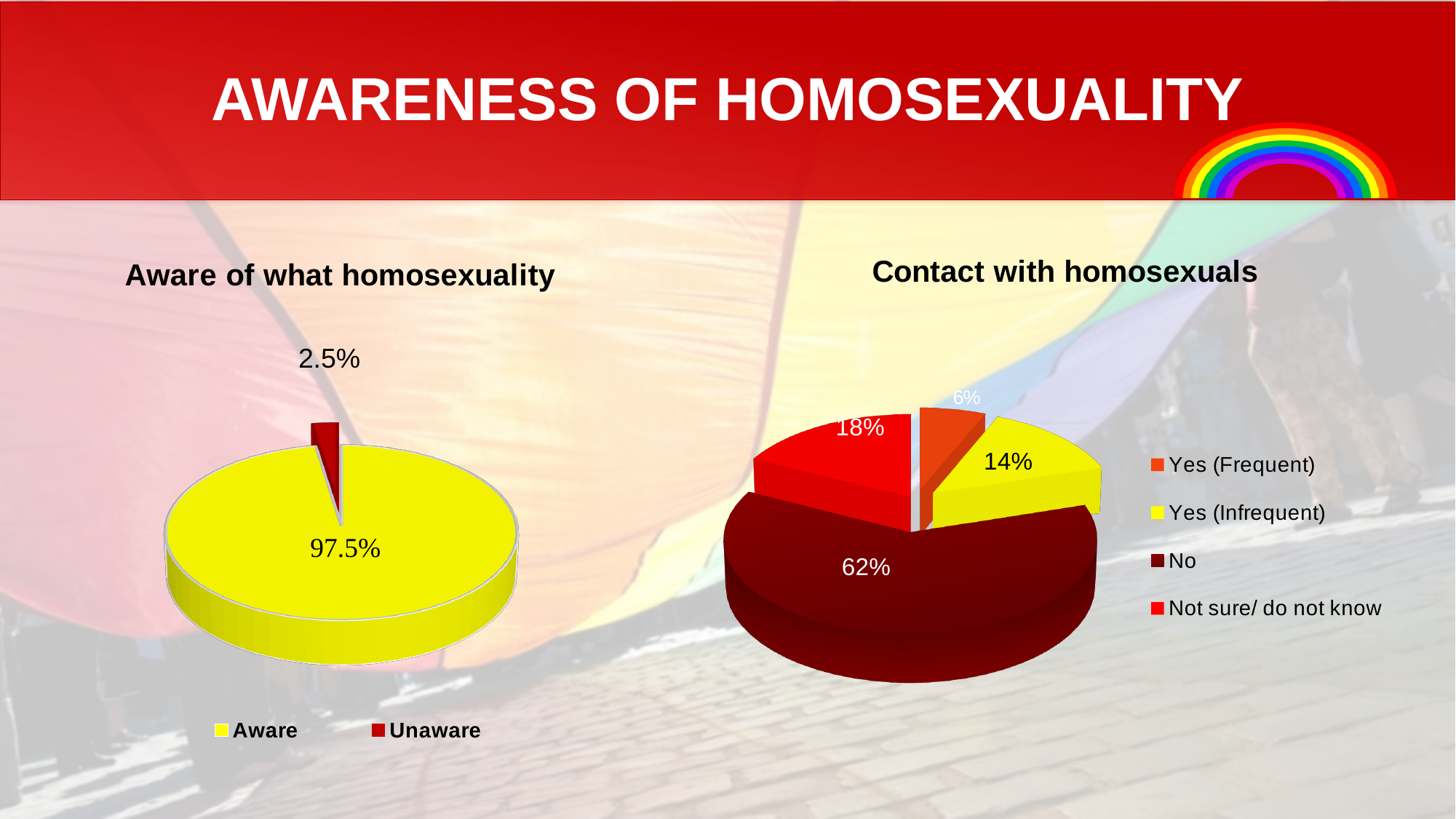
In the 'Contact with homosexuals' chart, which is larger: Not sure/ do not know or Yes (Infrequent)? Not sure/ do not know In the 'Aware of what homosexuality' chart, what is the difference between the Aware and Unaware shares? 95% What kind of chart is the 'Contact with homosexuals' chart? Pie chart In the 'Contact with homosexuals' chart, how many categories does the legend list? 4 In the 'Aware of what homosexuality' chart, what percentage is Unaware? 2.5% In the 'Contact with homosexuals' chart, what percentage is Not sure/ do not know? 18% In the 'Contact with homosexuals' chart, what percentage is Yes (Infrequent)? 14% In the 'Aware of what homosexuality' chart, which category has the largest share? Aware In the 'Contact with homosexuals' chart, which category has the smallest share? Yes (Frequent) In the 'Aware of what homosexuality' chart, how many categories are shown? 2 In the 'Aware of what homosexuality' chart, what percentage is Aware? 97.5% In the 'Contact with homosexuals' chart, what percentage is No? 62%